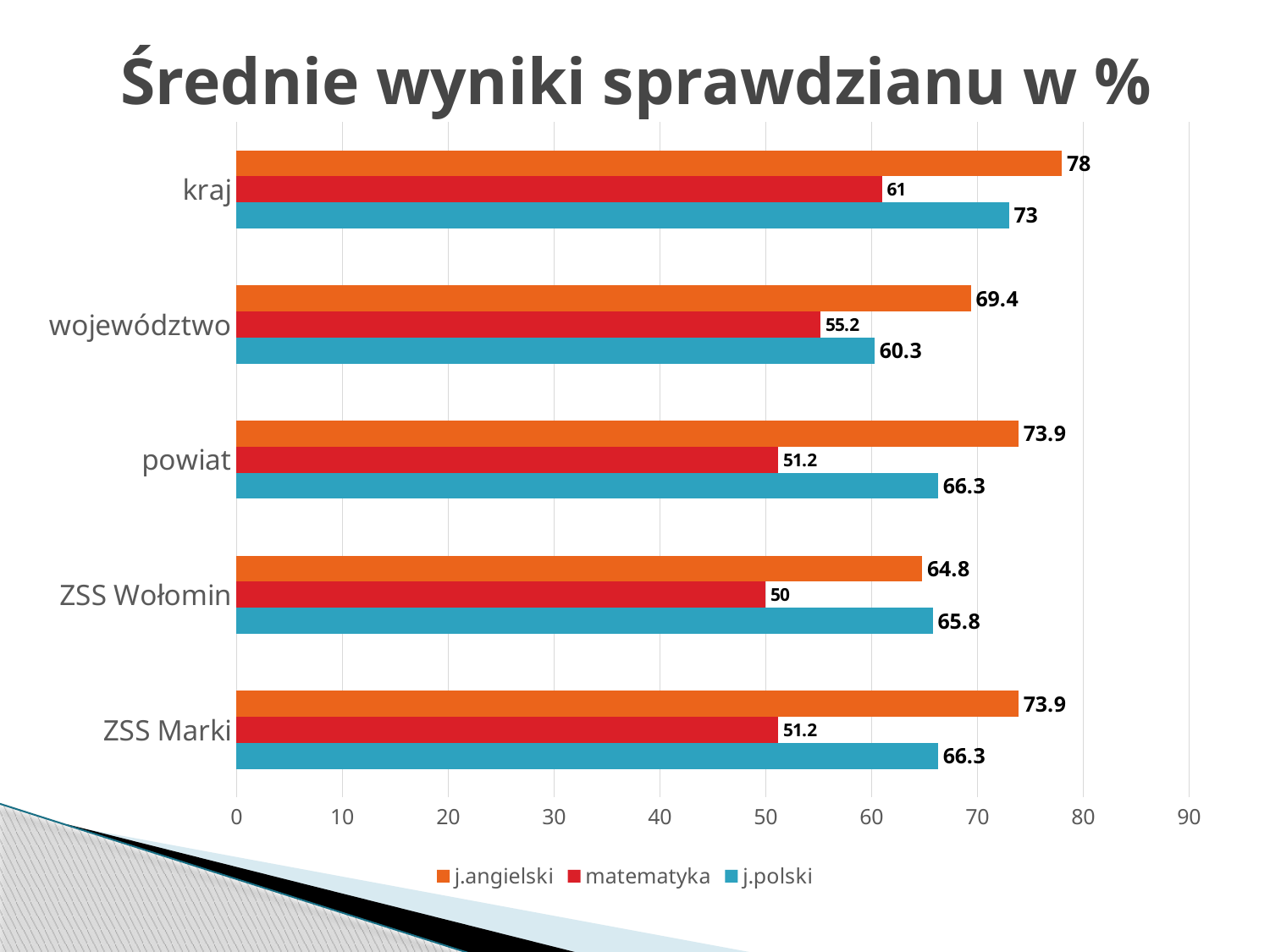
What is the matematyka value for ZSS Marki? 51.2 Which category has the highest j.angielski value? kraj Which is larger: the j.polski value for kraj or the j.polski value for powiat? kraj How many series does the legend list? 3 Which category has the lowest matematyka value? ZSS Wołomin What kind of chart is shown on the slide? bar chart How many categories are shown on the y axis? 5 What is the j.angielski value for kraj? 78 What is the difference between the j.angielski value for kraj and the j.angielski value for ZSS Wołomin? 13.2 What is the title of the chart? Średnie wyniki sprawdzianu w % What is the j.polski value for ZSS Wołomin? 65.8 What is the matematyka value for województwo? 55.2